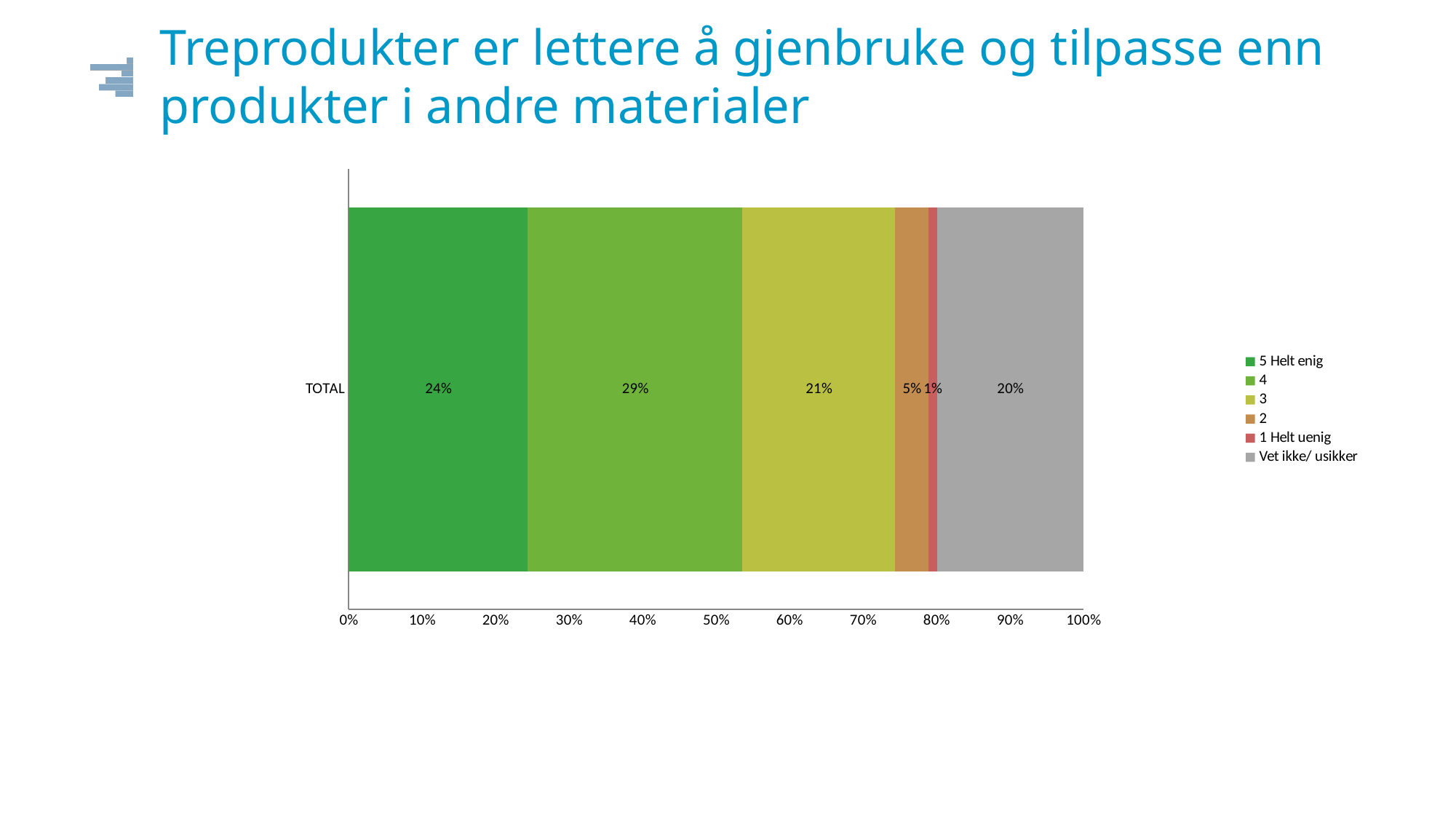
Which series has the highest value in the TOTAL bar? 4 What is the difference between the values for "4" and "5 Helt enig"? 5% What is the value for "2" in the TOTAL bar? 5% Which series has the lowest value in the TOTAL bar? 1 Helt uenig What is the value for "5 Helt enig" in the TOTAL bar? 24% What kind of chart is shown on the slide? Stacked bar chart Which is larger, the value for "3" or the value for "Vet ikke/ usikker"? 3 What is the value for "3" in the TOTAL bar? 21% How many series does the legend list? 6 What is the value for "Vet ikke/ usikker" in the TOTAL bar? 20% What is the value for "4" in the TOTAL bar? 29% What is the value for "1 Helt uenig" in the TOTAL bar? 1%